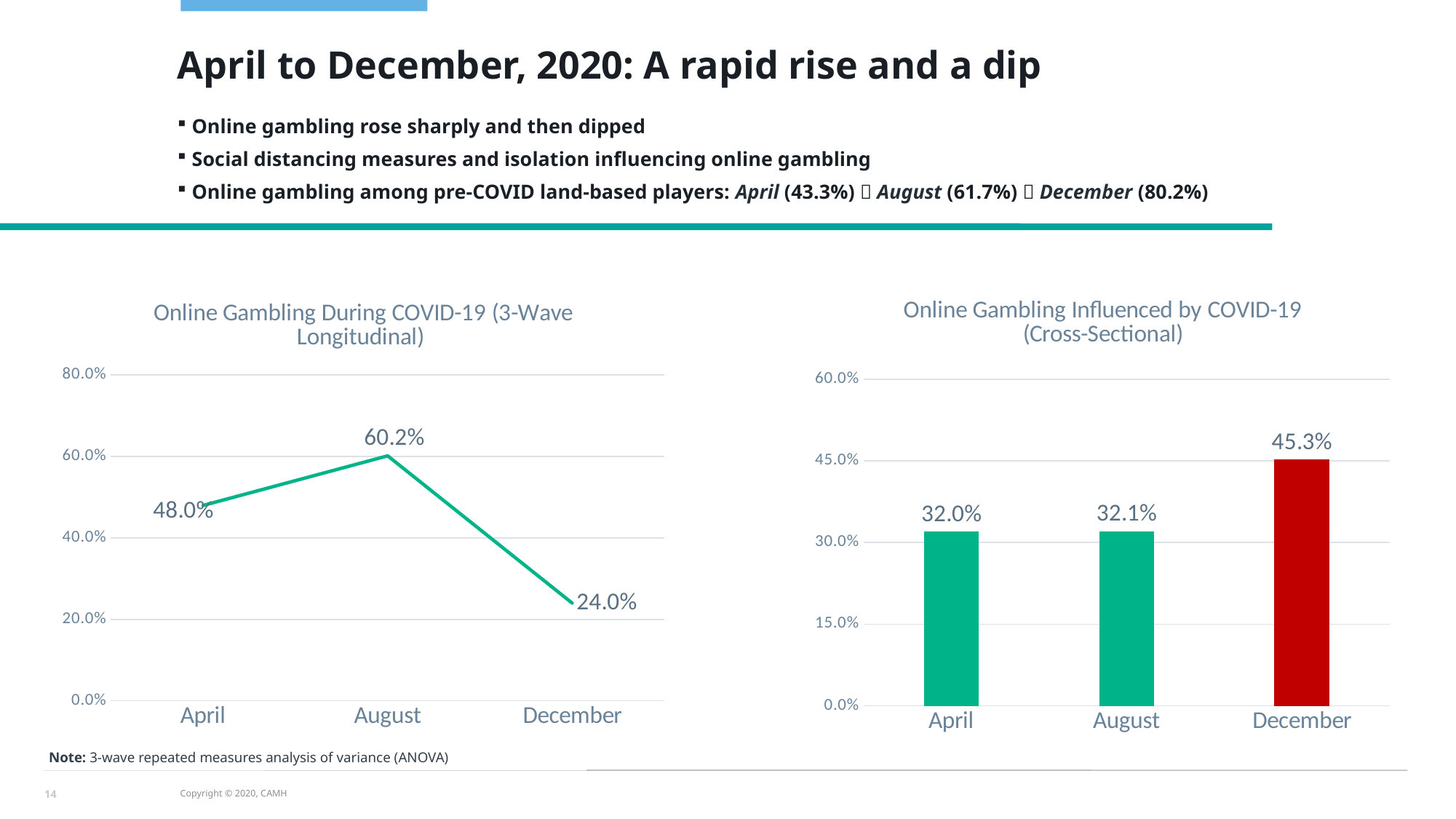
In the 'Online Gambling During COVID-19 (3-Wave Longitudinal)' chart, which month has the highest value? August In the 'Online Gambling Influenced by COVID-19 (Cross-Sectional)' chart, what is the difference between the December and August values? 13.2% In the 'Online Gambling Influenced by COVID-19 (Cross-Sectional)' chart, what is the value for April? 32.0% In the 'Online Gambling During COVID-19 (3-Wave Longitudinal)' chart, what is the value for December? 24.0% In the 'Online Gambling Influenced by COVID-19 (Cross-Sectional)' chart, which month has the highest value? December In the 'Online Gambling Influenced by COVID-19 (Cross-Sectional)' chart, what is the value for December? 45.3% What kind of chart is the 'Online Gambling During COVID-19 (3-Wave Longitudinal)' chart? Line chart In the 'Online Gambling Influenced by COVID-19 (Cross-Sectional)' chart, what colour is the December bar? Red In the 'Online Gambling During COVID-19 (3-Wave Longitudinal)' chart, how many data points are plotted? 3 In the 'Online Gambling During COVID-19 (3-Wave Longitudinal)' chart, what is the value for August? 60.2% In the 'Online Gambling During COVID-19 (3-Wave Longitudinal)' chart, what is the difference between the April and December values? 24.0% What kind of chart is the 'Online Gambling Influenced by COVID-19 (Cross-Sectional)' chart? Bar chart